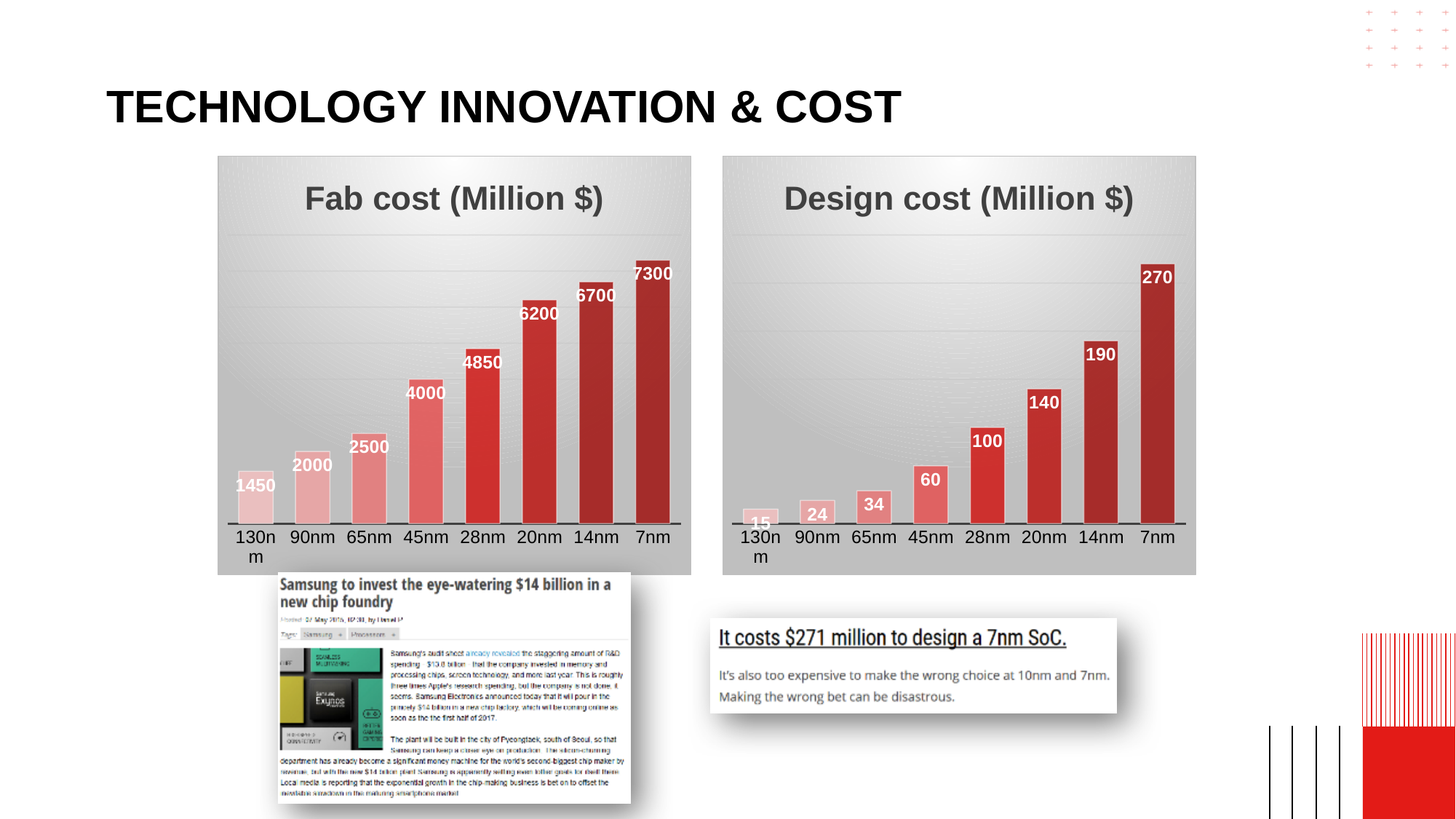
What is the title of the chart on the left side of the slide? Fab cost (Million $) In the Fab cost (Million $) chart, do the values rise or fall from 130nm to 7nm? rise In the Design cost (Million $) chart, what is the value for 90nm? 24 In the Fab cost (Million $) chart, which category has the highest value? 7nm In the Fab cost (Million $) chart, what is the value for 28nm? 4850 In the Design cost (Million $) chart, which is larger, the value for 20nm or the value for 65nm? 20nm In the Design cost (Million $) chart, what is the value for 14nm? 190 In the Design cost (Million $) chart, which category has the lowest value? 130nm In the Fab cost (Million $) chart, what is the difference between the values for 7nm and 14nm? 600 What kind of chart is the Design cost (Million $) chart? bar chart How many categories are shown in the Fab cost (Million $) chart? 8 In the Design cost (Million $) chart, what is the difference between the values for 28nm and 45nm? 40